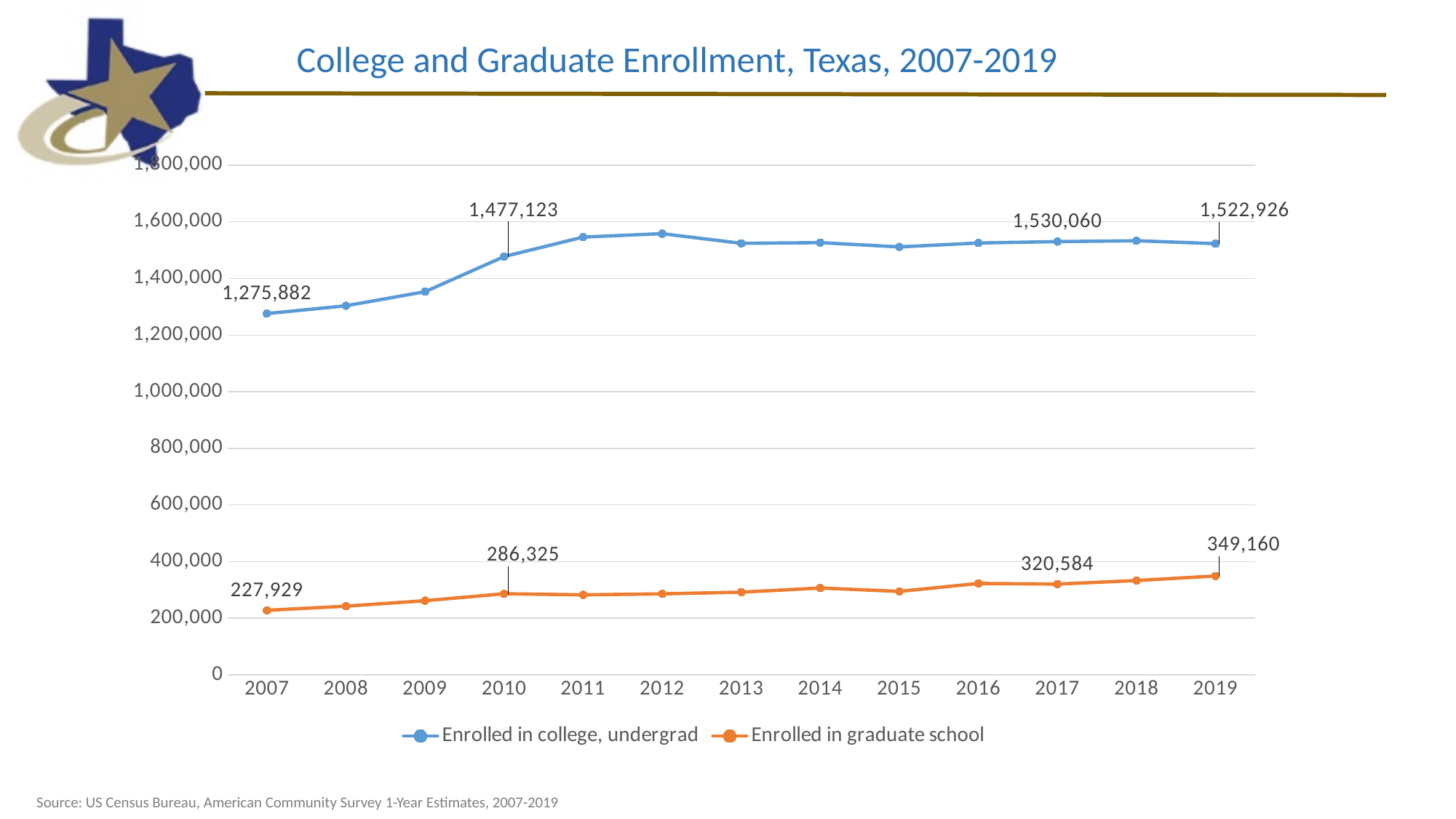
How many series does the legend list? 2 What was the number enrolled in college, undergrad in 2007? 1,275,882 By how much did undergrad enrollment increase from 2007 to 2019? 247,044 Does graduate school enrollment generally rise or fall from 2007 to 2019? Rise Is the value for undergrad enrollment in 2012 greater or less than 1,400,000? greater Which year has the highest graduate school enrollment? 2019 How many years are plotted along the x axis? 13 What was the number enrolled in graduate school in 2019? 349,160 What was the number enrolled in graduate school in 2017? 320,584 What was the number enrolled in college, undergrad in 2010? 1,477,123 What type of chart is shown on the slide? Line chart What is the difference between graduate school enrollment in 2019 and 2017? 28,576